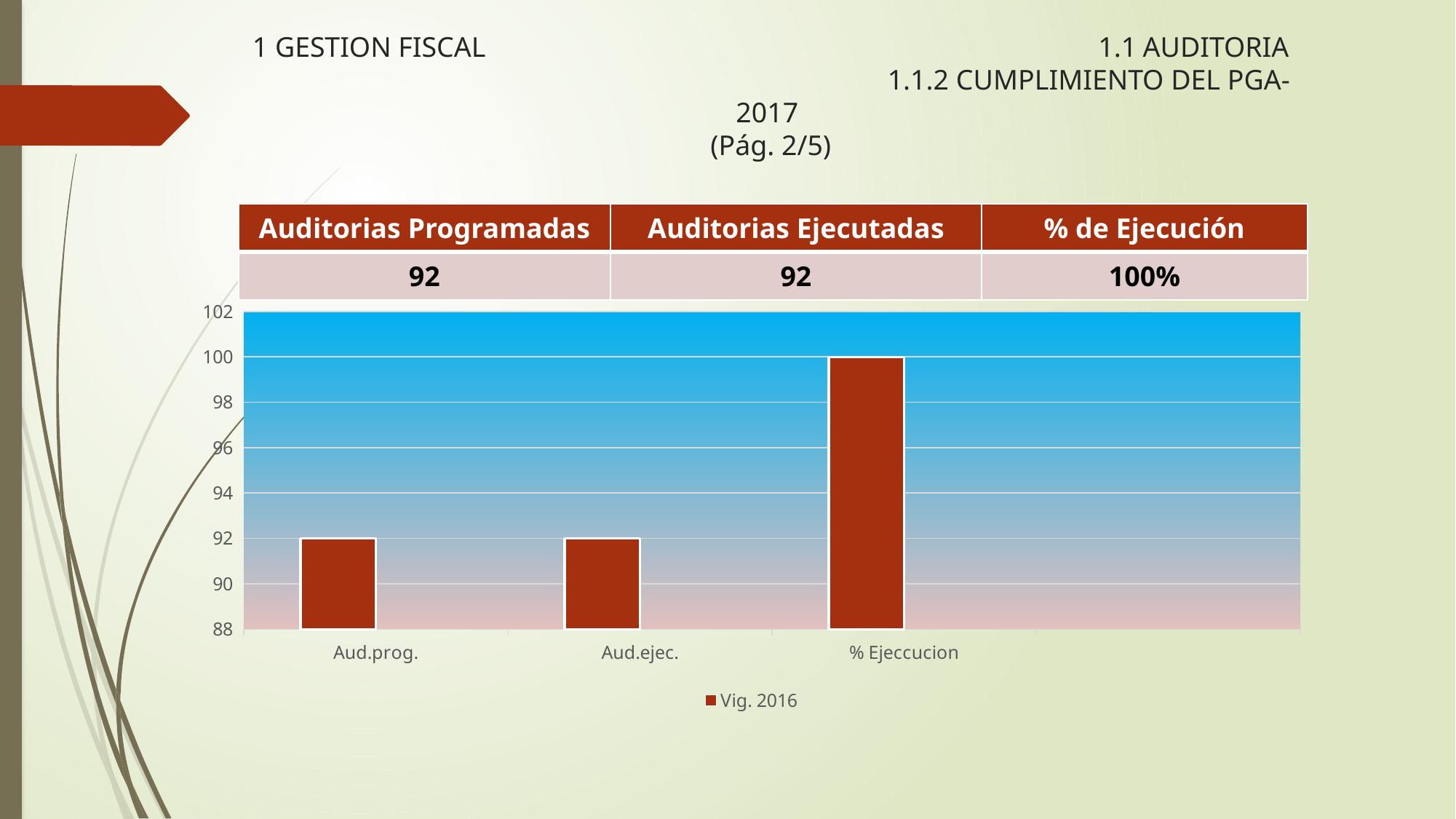
What is the value of the bar for % Ejeccucion? 100 Which is larger, the bar for % Ejeccucion or the bar for Aud.ejec.? % Ejeccucion What is the lowest value shown on the chart's vertical axis? 88 What is the value of the bar for Aud.ejec.? 92 How many series does the chart legend list? 1 Which category has the highest bar in the chart? % Ejeccucion What is the difference between the bar for % Ejeccucion and the bar for Aud.prog.? 8 How many categories are plotted on the x axis of the chart? 3 What type of chart is shown on the slide? bar chart What is the name of the series shown in the chart legend? Vig. 2016 Is the value for Aud.prog. greater or less than 96? less What is the value of the bar for Aud.prog.? 92